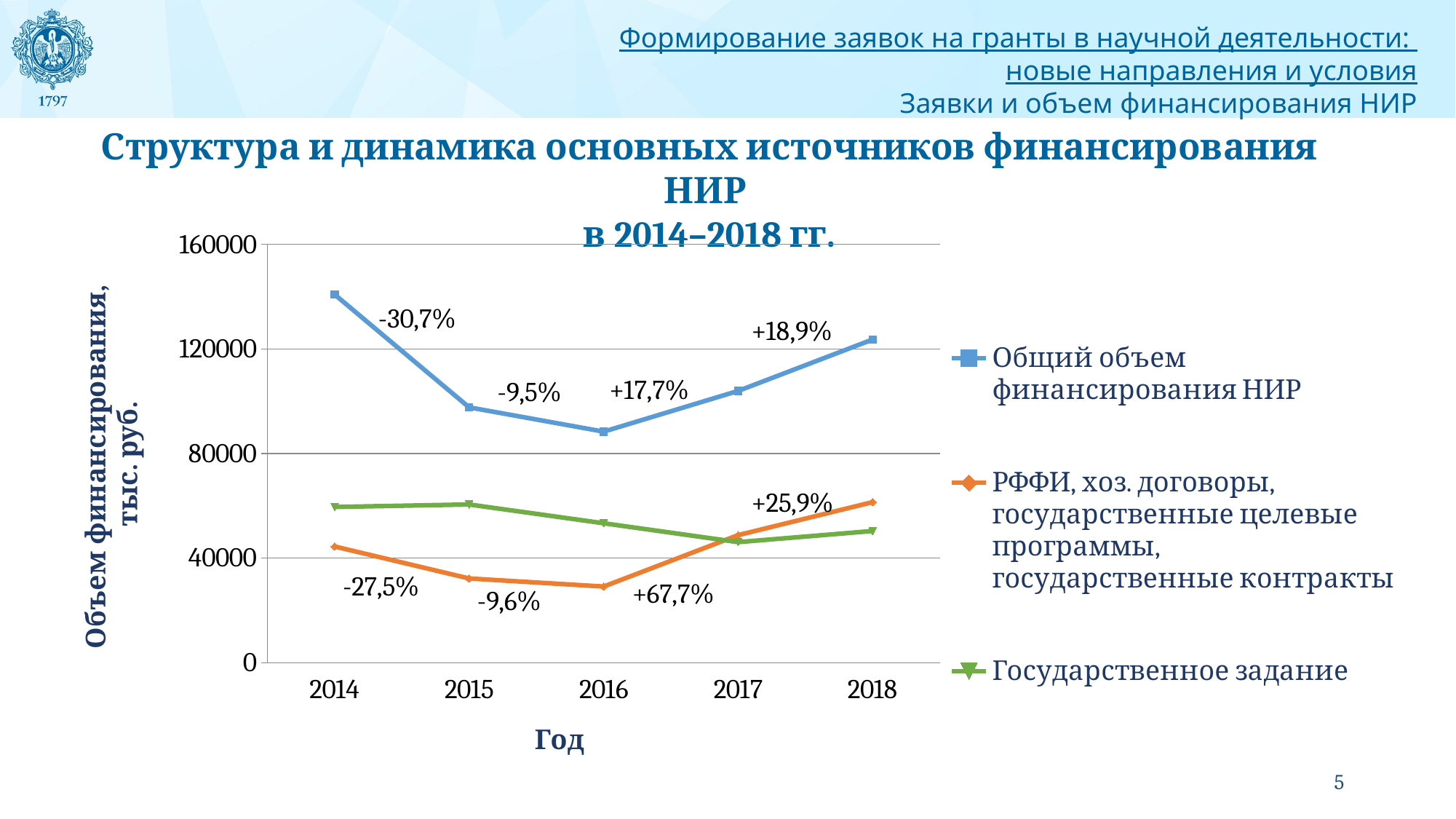
What percentage change is labelled for Общий объем финансирования НИР between 2014 and 2015? -30,7% Is the value for the РФФИ, хоз. договоры series in 2016 greater or less than 40000? less How many years are plotted along the x axis? 5 What percentage change is labelled for the РФФИ, хоз. договоры series between 2015 and 2016? -9,6% What percentage change is labelled for the РФФИ, хоз. договоры series between 2016 and 2017? +67,7% In which year is the РФФИ, хоз. договоры series lowest? 2016 What kind of chart is shown on the slide? line chart Is the value for Общий объем финансирования НИР in 2014 greater or less than 120000? greater In 2018, which is larger: the РФФИ, хоз. договоры series or Государственное задание? РФФИ, хоз. договоры, государственные целевые программы, государственные контракты What percentage change is labelled for Общий объем финансирования НИР between 2017 and 2018? +18,9% How many series does the legend list? 3 In which year is Общий объем финансирования НИР highest? 2014